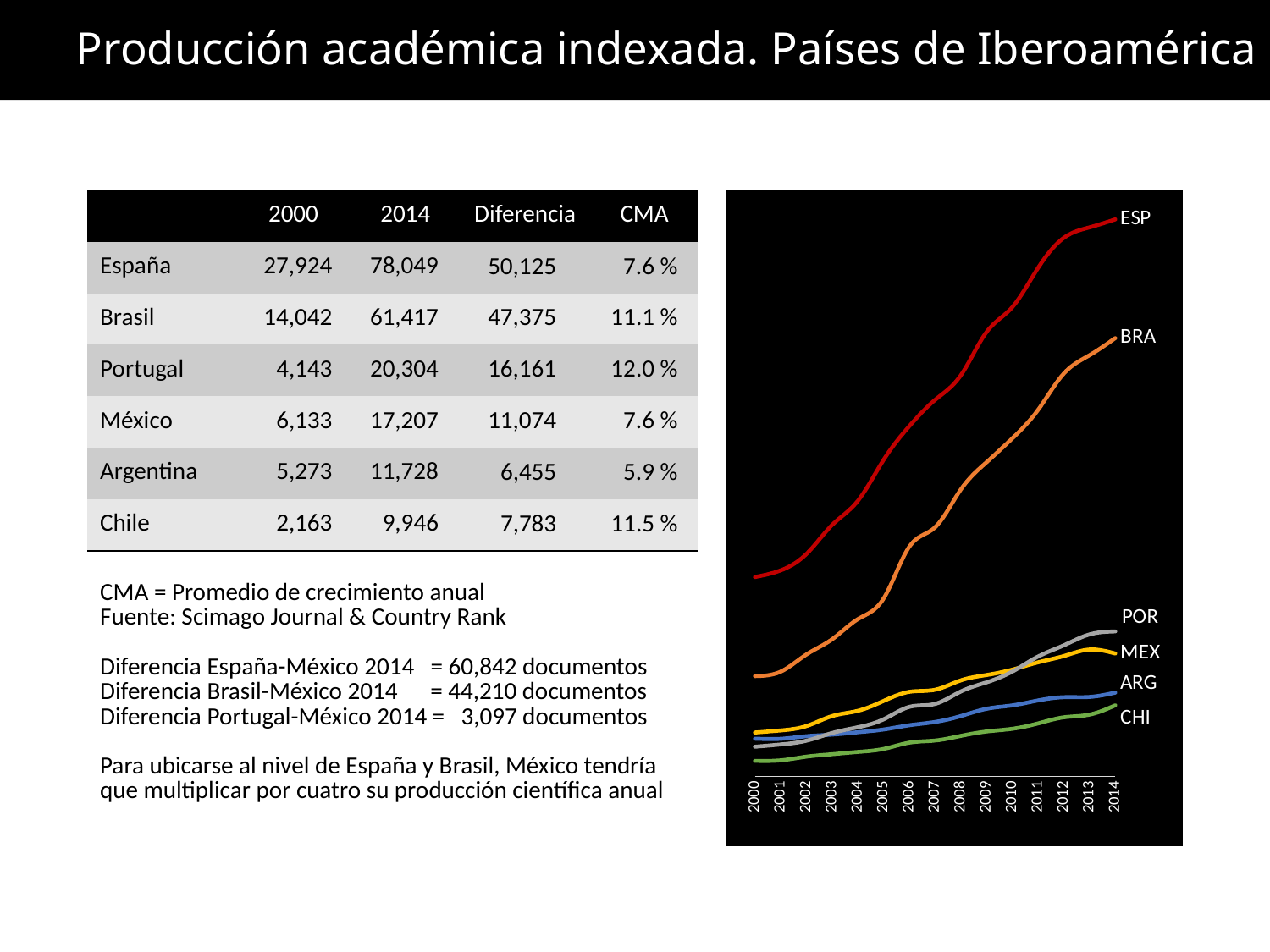
What is the last year shown on the x axis of the line chart? 2014 Does the ESP line rise or fall from 2000 to 2014? rise What is the first year shown on the x axis of the line chart? 2000 According to the slide, what is the value for Brasil (BRA) in 2000? 14,042 Which series is highest in the line chart in 2014? ESP How many series (countries) are plotted in the line chart? 6 What kind of chart is shown on the right side of the slide? line chart Which series is lowest in the line chart in 2014? CHI In 2014, which line is higher, POR or MEX? POR According to the slide, what is the value for España (ESP) in 2014? 78,049 How many years are shown along the x axis of the line chart? 15 In 2014, which line is higher, ARG or CHI? ARG